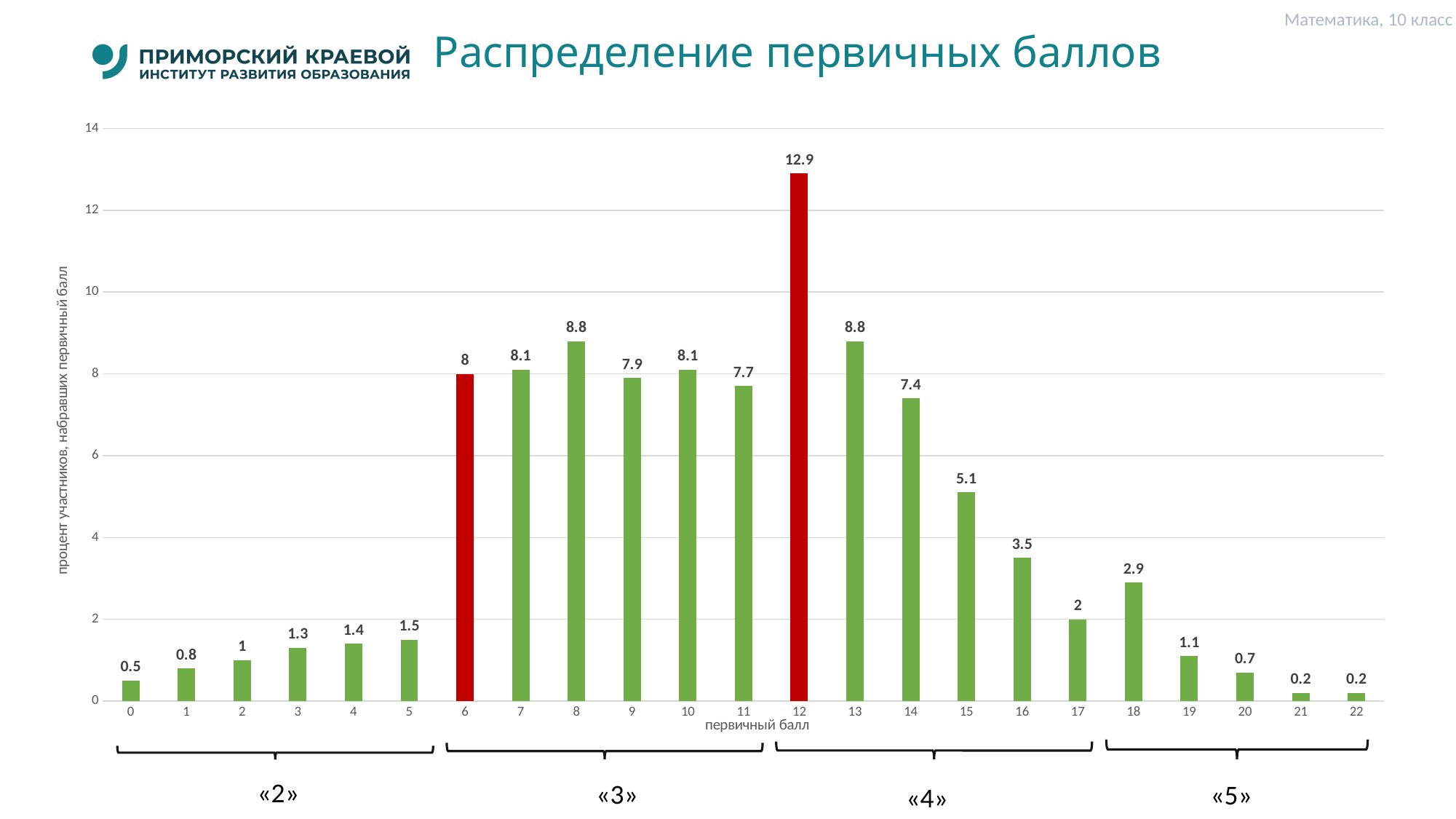
Is the value for primary score 14 greater or less than 8? less What is the difference between the values for primary scores 15 and 16? 1.6 What is the difference between the values for primary scores 12 and 13? 4.1 What kind of chart is shown on the slide? bar chart Which primary score has the highest percentage of participants? 12 Do the values rise or fall along the x axis from primary score 13 to primary score 17? fall Which two primary scores are shown with red bars? 6 and 12 What is the value shown for a primary score of 6? 8 What percentage of participants scored a primary score of 12? 12.9 Which is larger, the value for primary score 9 or the value for primary score 10? 10 What is the value shown for a primary score of 17? 2 How many primary score categories are shown on the x axis? 23